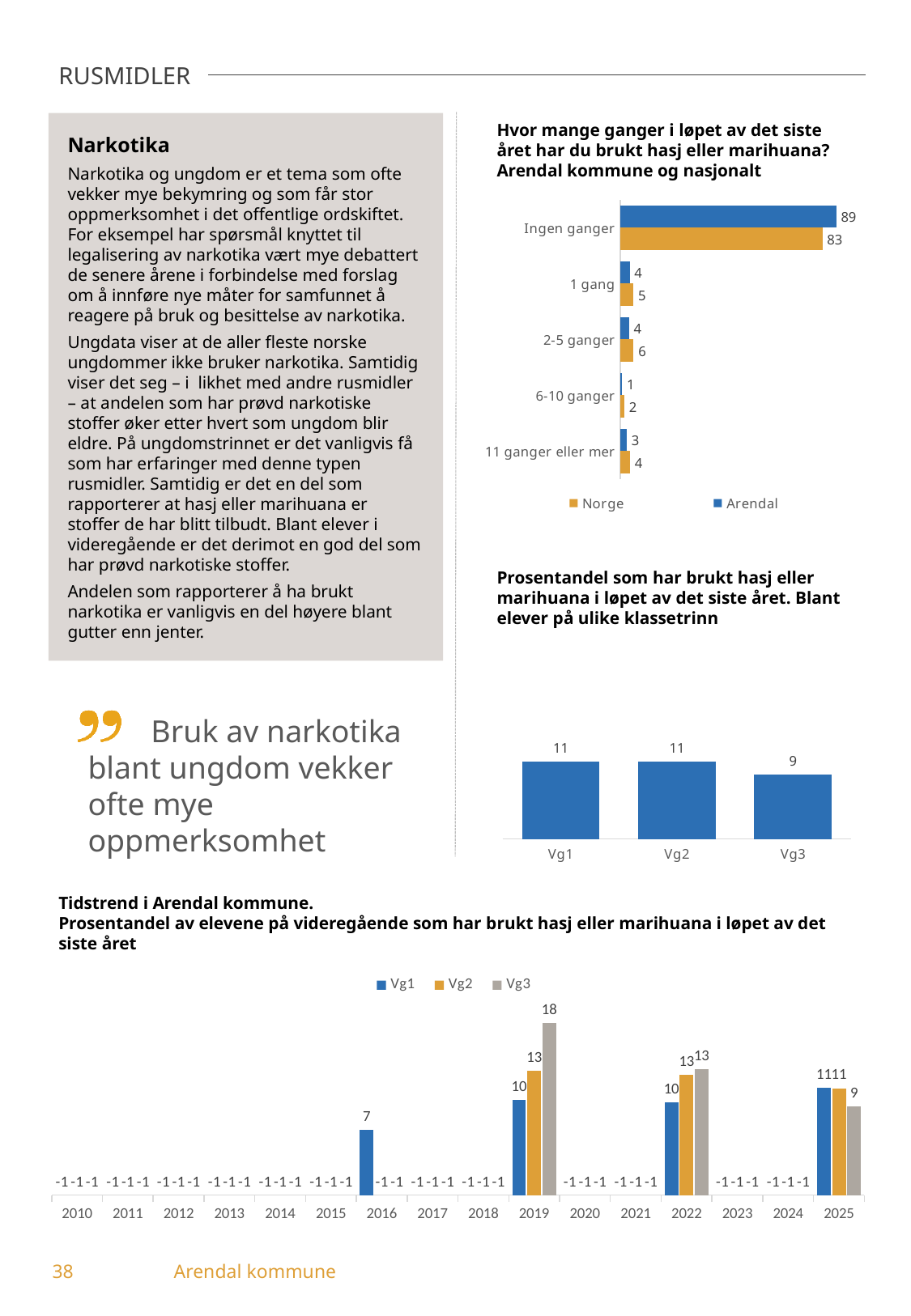
In the chart 'Hvor mange ganger i løpet av det siste året har du brukt hasj eller marihuana?', what is the value for Arendal in the 'Ingen ganger' category? 89 In the chart 'Hvor mange ganger i løpet av det siste året har du brukt hasj eller marihuana?', what is the value for Norge in the '2-5 ganger' category? 6 In the chart 'Tidstrend i Arendal kommune', what is the difference between Vg3 in 2019 and Vg3 in 2025? 9 What kind of chart is 'Hvor mange ganger i løpet av det siste året har du brukt hasj eller marihuana?'? Bar chart In the chart 'Hvor mange ganger i løpet av det siste året har du brukt hasj eller marihuana?', what is the difference between Arendal and Norge for 'Ingen ganger'? 6 In the chart 'Tidstrend i Arendal kommune', which is larger in 2022: Vg1 or Vg2? Vg2 In the chart 'Prosentandel som har brukt hasj eller marihuana i løpet av det siste året. Blant elever på ulike klassetrinn', what is the value for Vg3? 9 In the chart 'Tidstrend i Arendal kommune', what is the value for Vg3 in 2019? 18 In the chart 'Hvor mange ganger i løpet av det siste året har du brukt hasj eller marihuana?', which category has the lowest value for Arendal? 6-10 ganger How many series does the legend list in the chart 'Hvor mange ganger i løpet av det siste året har du brukt hasj eller marihuana?'? 2 In the chart 'Prosentandel som har brukt hasj eller marihuana i løpet av det siste året. Blant elever på ulike klassetrinn', how many categories are shown? 3 In the chart 'Tidstrend i Arendal kommune', what is the value for Vg1 in 2016? 7